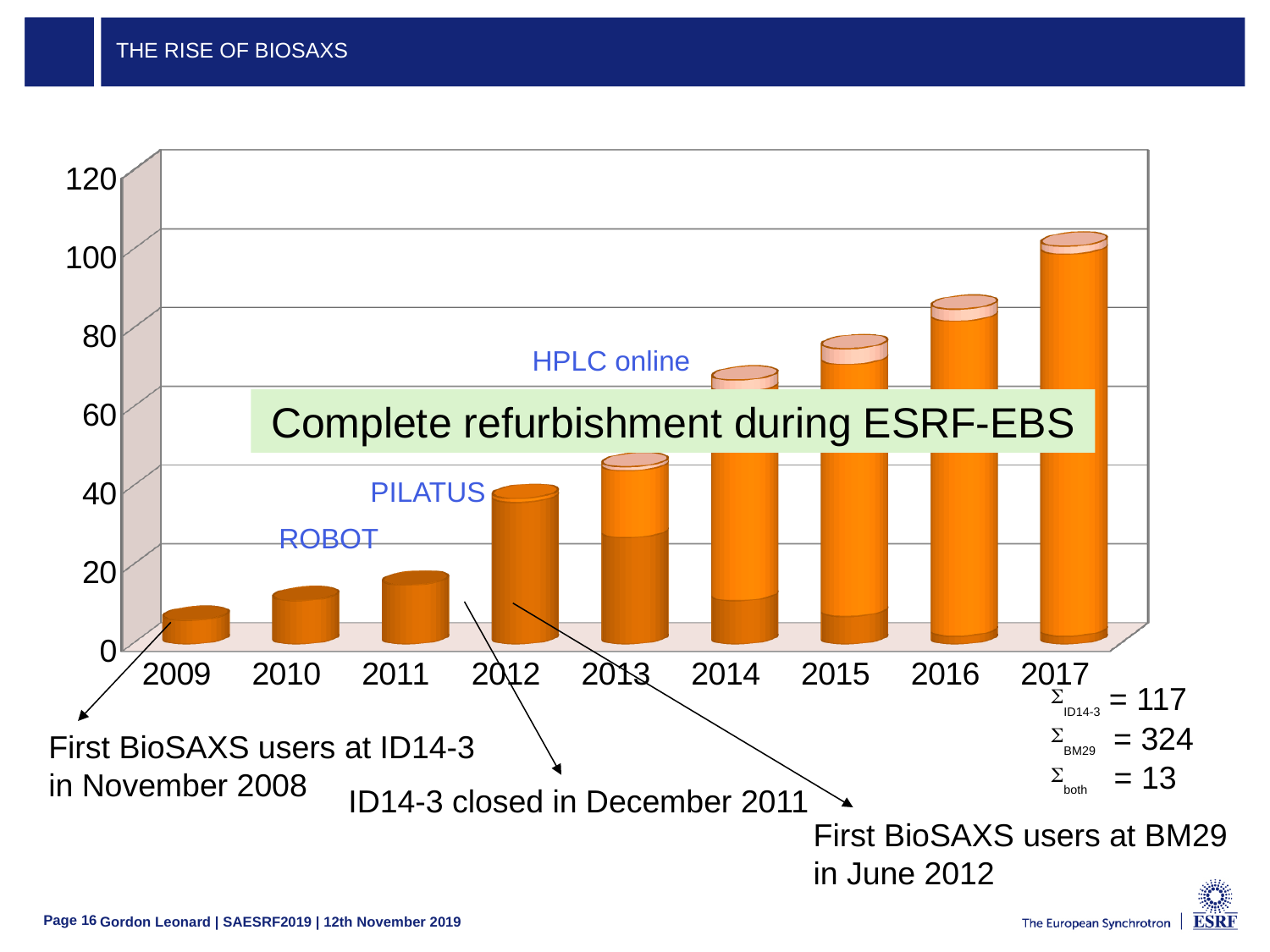
Which year has the shortest bar in the chart? 2009 How many years are shown on the x axis of the chart? 9 What is the highest value shown on the y axis of the chart? 120 Is the value for 2012 greater or less than 20? greater Is the value for 2009 greater or less than 20? less Is the value for 2014 greater or less than 80? less Which year has the larger bar, 2013 or 2016? 2016 What kind of chart is shown on the slide? bar chart Do the bar values rise or fall from 2009 to 2017? rise What is the first year shown on the x axis of the chart? 2009 Which year has the tallest bar in the chart? 2017